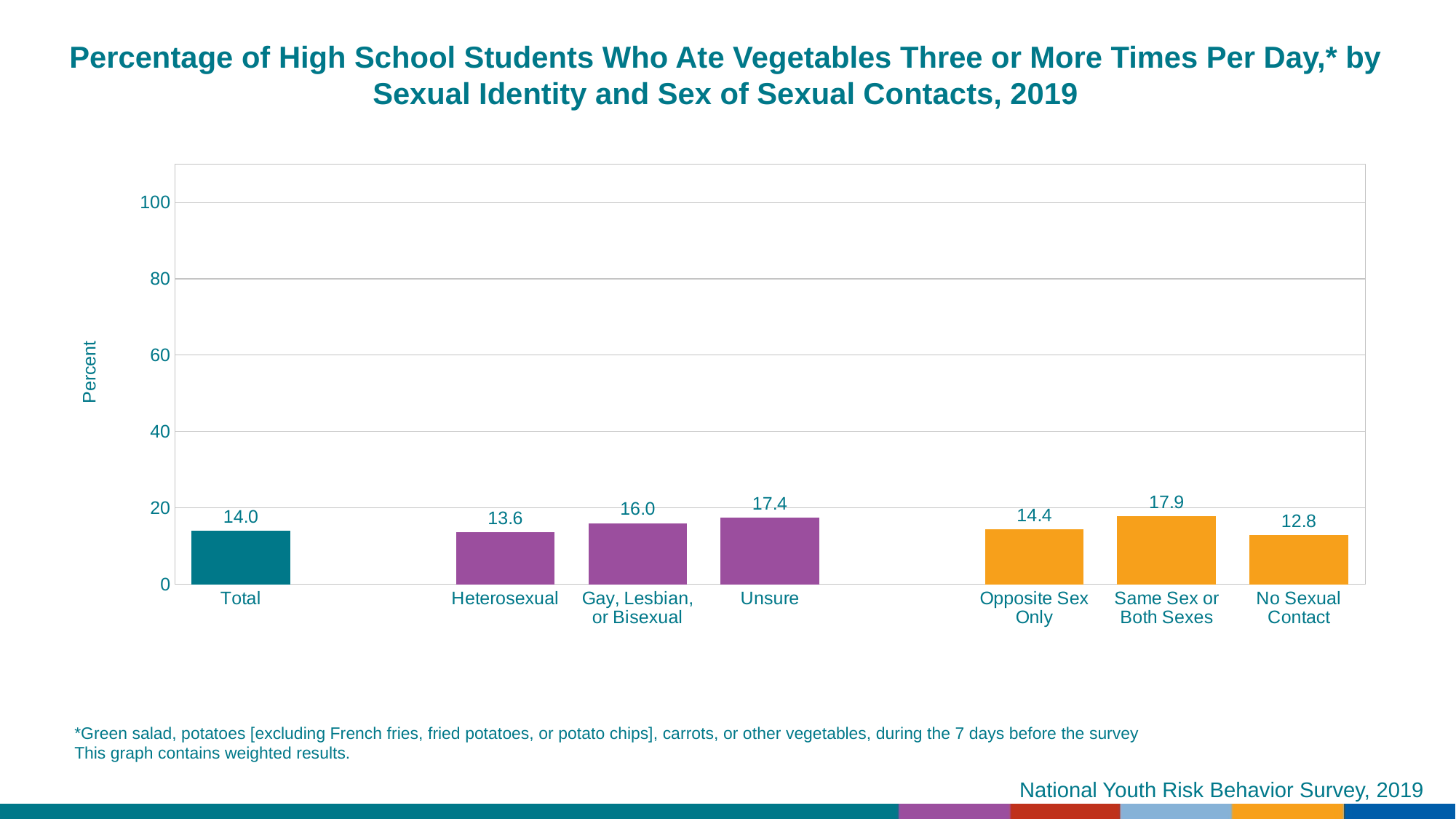
Which is larger, the value for Gay, Lesbian, or Bisexual or the value for Opposite Sex Only? Gay, Lesbian, or Bisexual What is the value for No Sexual Contact? 12.8 What is the value for Heterosexual? 13.6 What kind of chart is shown on the slide? bar chart What is the value for Same Sex or Both Sexes? 17.9 Is the value for Unsure greater or less than 20? less What is the difference between the values for Unsure and Heterosexual? 3.8 What is the label of the vertical axis? Percent What is the value for Total? 14.0 Which category has the lowest value? No Sexual Contact How many categories are shown in the chart? 7 Which category has the highest value? Same Sex or Both Sexes